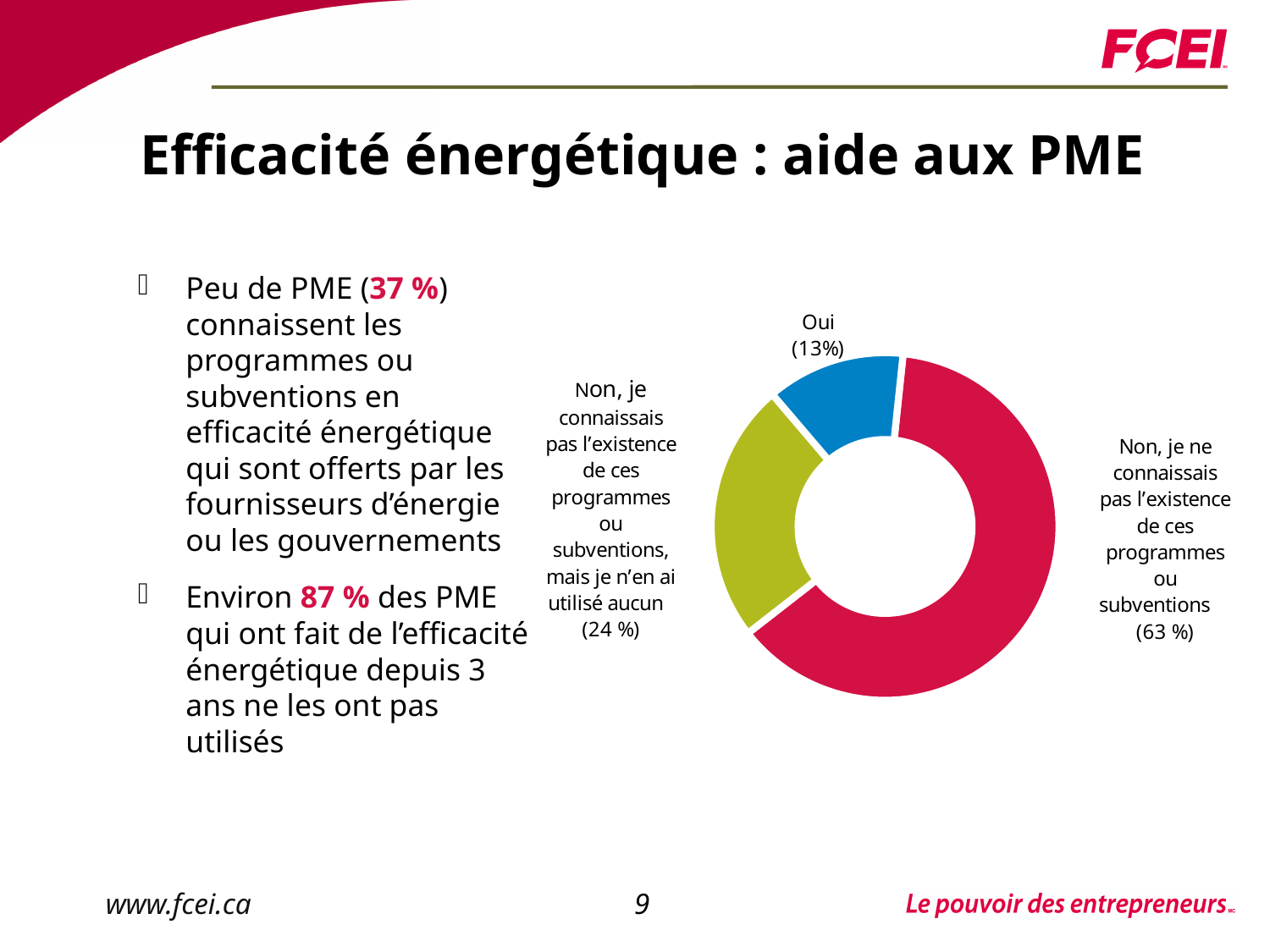
What is the difference in percentage points between the "Non, je connaissais pas l'existence... mais je n'en ai utilisé aucun" slice and the "Oui" slice? 11 Which slice of the pie is the largest? Non, je ne connaissais pas l'existence de ces programmes ou subventions Which slice of the pie is the smallest? Oui What is the difference in percentage points between the "Non, je ne connaissais pas l'existence" slice and the "Oui" slice? 50 What share of the pie does the "Oui" slice represent? 13% What share of the pie does the slice "Non, je connaissais pas l'existence de ces programmes ou subventions, mais je n'en ai utilisé aucun" represent? 24 % How many slices does the pie chart have? 3 What colour is the largest slice of the pie? Red What colour is the "Oui" slice of the pie? Blue What share of the pie does the slice "Non, je ne connaissais pas l'existence de ces programmes ou subventions" represent? 63 % What kind of chart is shown on the slide? Pie chart (donut) Which is larger: the "Oui" slice or the "Non, je connaissais pas l'existence... mais je n'en ai utilisé aucun" slice? Non, je connaissais pas l'existence... mais je n'en ai utilisé aucun